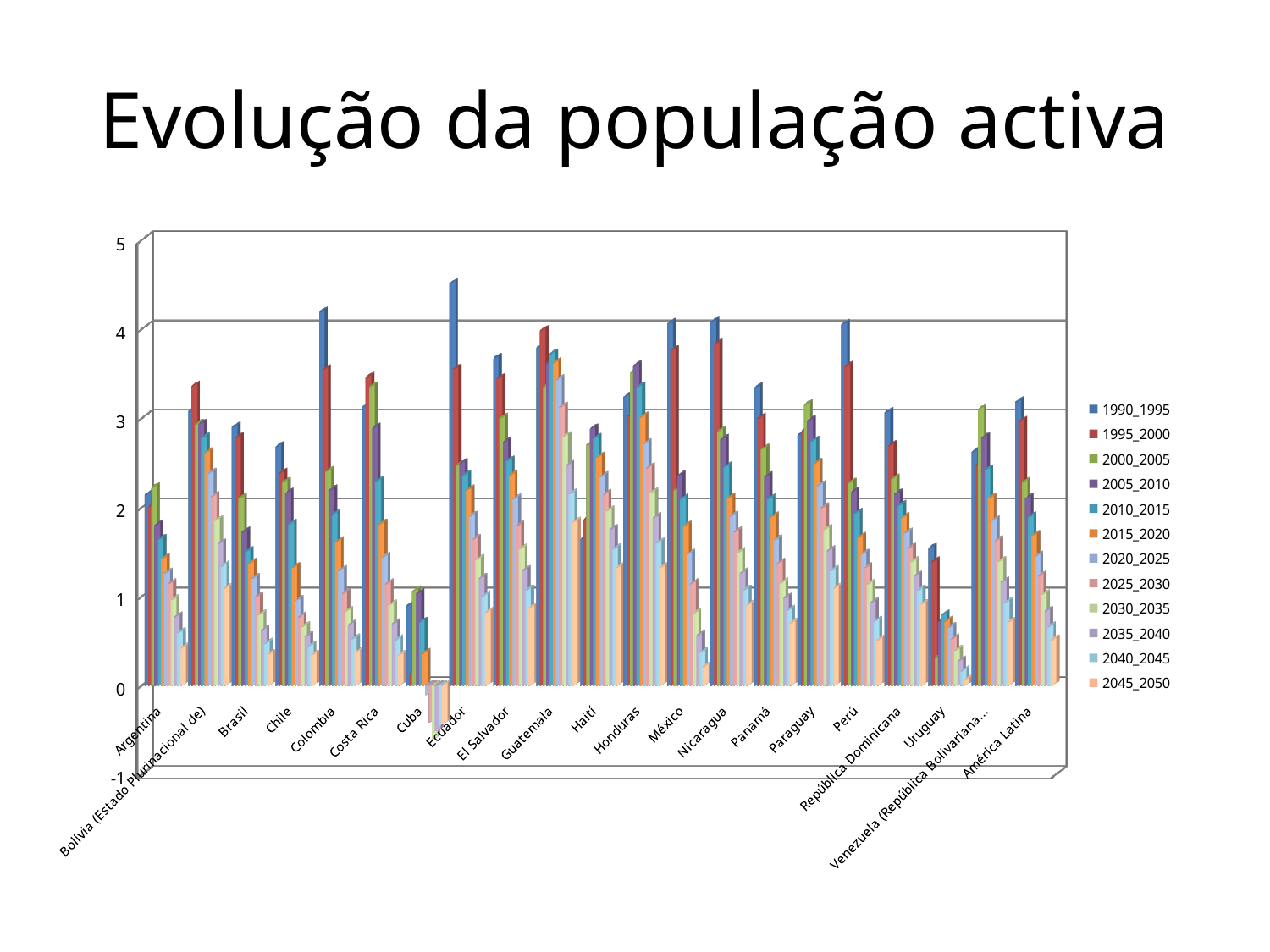
Is the 1990_1995 value for Uruguay greater or less than 2? less Which country has the highest 1990_1995 value? Ecuador How many series does the legend list? 12 Is the 1990_1995 value for Cuba greater or less than 2? less Is the 1990_1995 value for Guatemala greater or less than 3? greater What kind of chart is shown on the slide? bar chart How many countries or regions are shown on the x axis? 21 Which is the first series listed in the legend? 1990_1995 Do the values for Argentina rise or fall from the 1990_1995 series to the 2045_2050 series? fall What is the title of the slide? Evolução da população activa Which of Ecuador and Uruguay has the larger 1990_1995 value? Ecuador